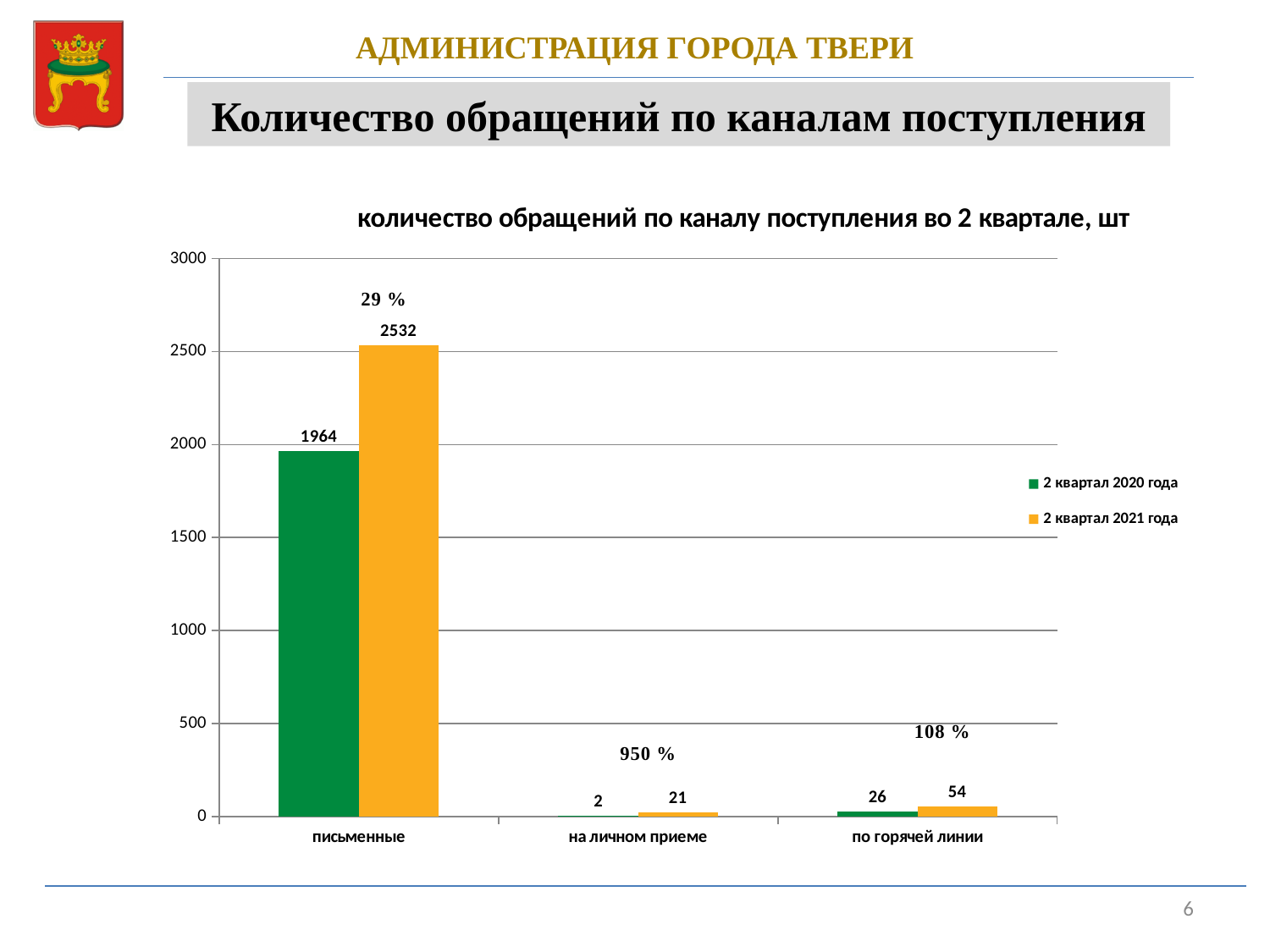
How many categories are shown on the x axis? 3 What is the difference between the 2 квартал 2021 года and 2 квартал 2020 года values for письменные? 568 Which category has the highest value in 2 квартал 2021 года? письменные What percentage change label is shown above the на личном приеме bars? 950 % What kind of chart is shown on the slide? bar chart Which is larger for по горячей линии: the 2 квартал 2020 года value or the 2 квартал 2021 года value? 2 квартал 2021 года What is the value for письменные in 2 квартал 2021 года? 2532 What is the value for письменные in 2 квартал 2020 года? 1964 What is the value for по горячей линии in 2 квартал 2021 года? 54 What is the value for на личном приеме in 2 квартал 2020 года? 2 Which category has the lowest value in 2 квартал 2020 года? на личном приеме How many series does the legend list? 2